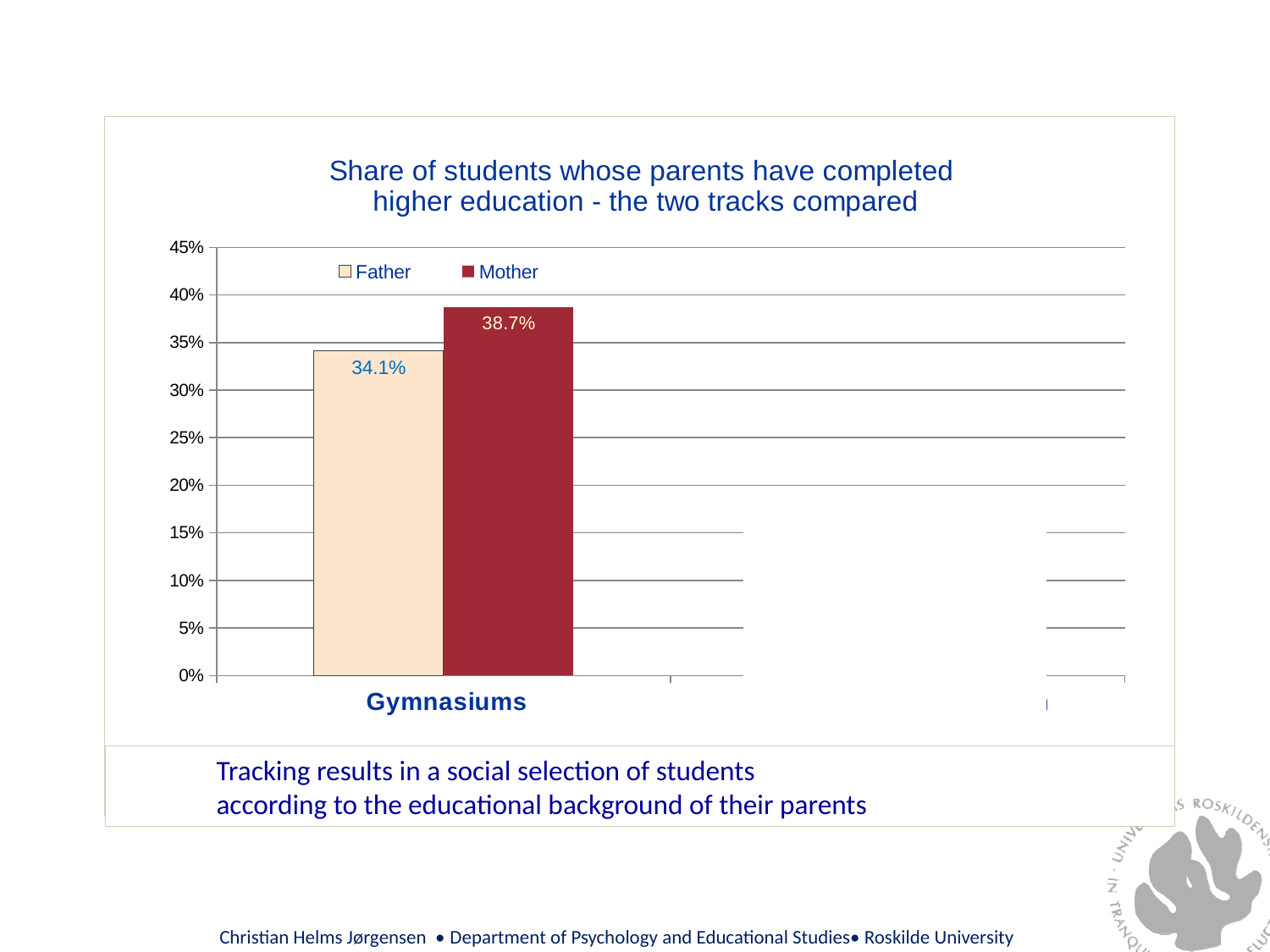
What is the title of the chart? Share of students whose parents have completed higher education - the two tracks compared What kind of chart is shown on the slide? Bar chart What is the difference between the Mother and Father values for Gymnasiums? 4.6% Is the value for Mother in the Gymnasiums category greater or less than 35%? greater What is the value for Father in the Gymnasiums category? 34.1% Which series has the higher value for Gymnasiums, Father or Mother? Mother What is the value for Mother in the Gymnasiums category? 38.7% How many series does the legend list? 2 What is the highest value shown on the y axis of the chart? 45% Is the value for Father in the Gymnasiums category greater or less than 35%? less Which series is shown in dark red in the chart? Mother